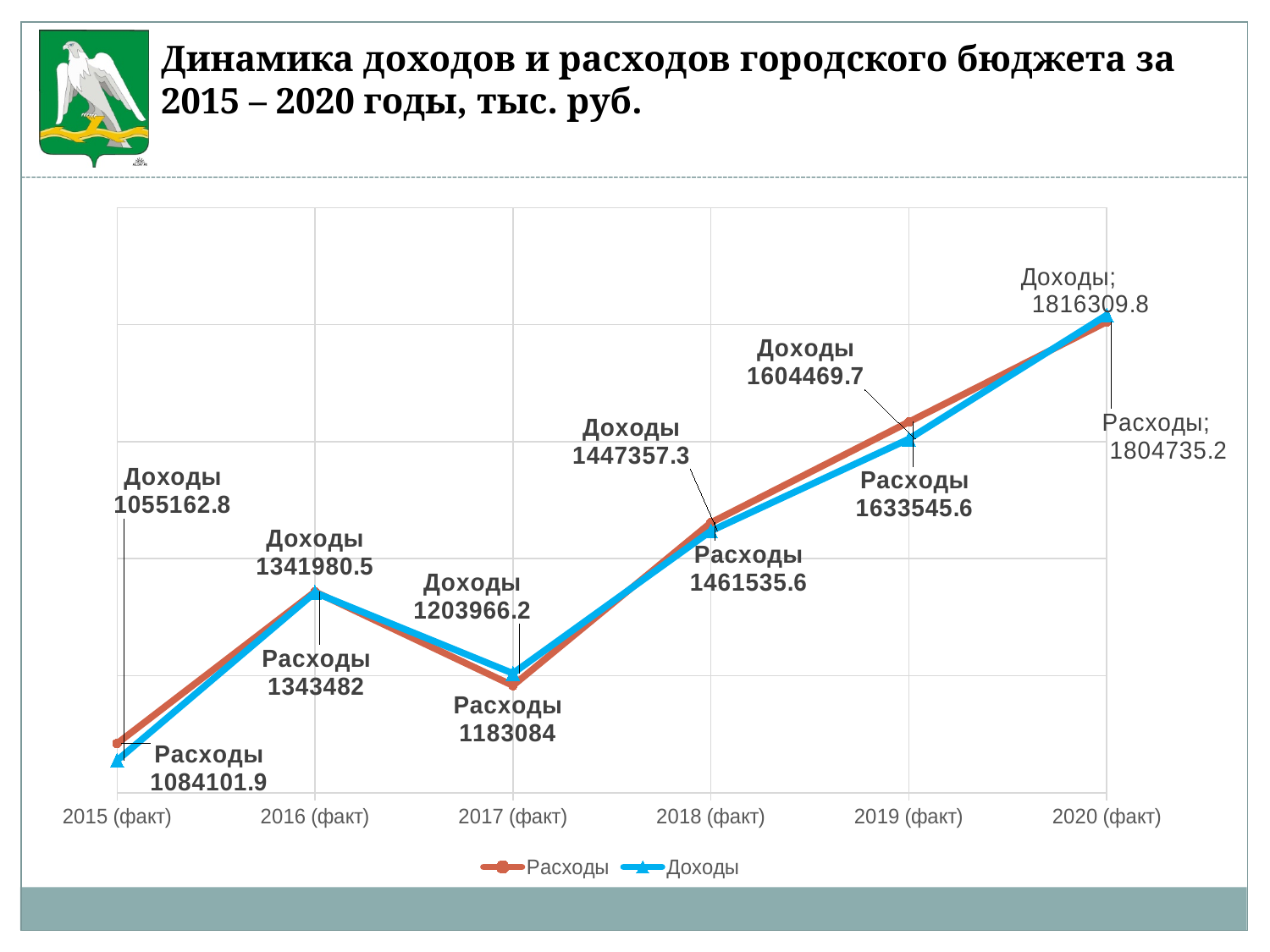
What is the value of Расходы for 2020 (факт)? 1804735.2 How many years are shown on the x axis? 6 What is the difference between Доходы and Расходы in 2020 (факт)? 11574.6 What is the value of Доходы for 2019 (факт)? 1604469.7 What kind of chart is shown on the slide? line chart In which year is Расходы lowest? 2015 (факт) In which year is Доходы highest? 2020 (факт) How many series does the legend list? 2 What is the difference between Расходы and Доходы in 2015 (факт)? 28939.1 What is the value of Доходы for 2015 (факт)? 1055162.8 Which is larger in 2017 (факт), Доходы or Расходы? Доходы What is the value of Расходы for 2017 (факт)? 1183084